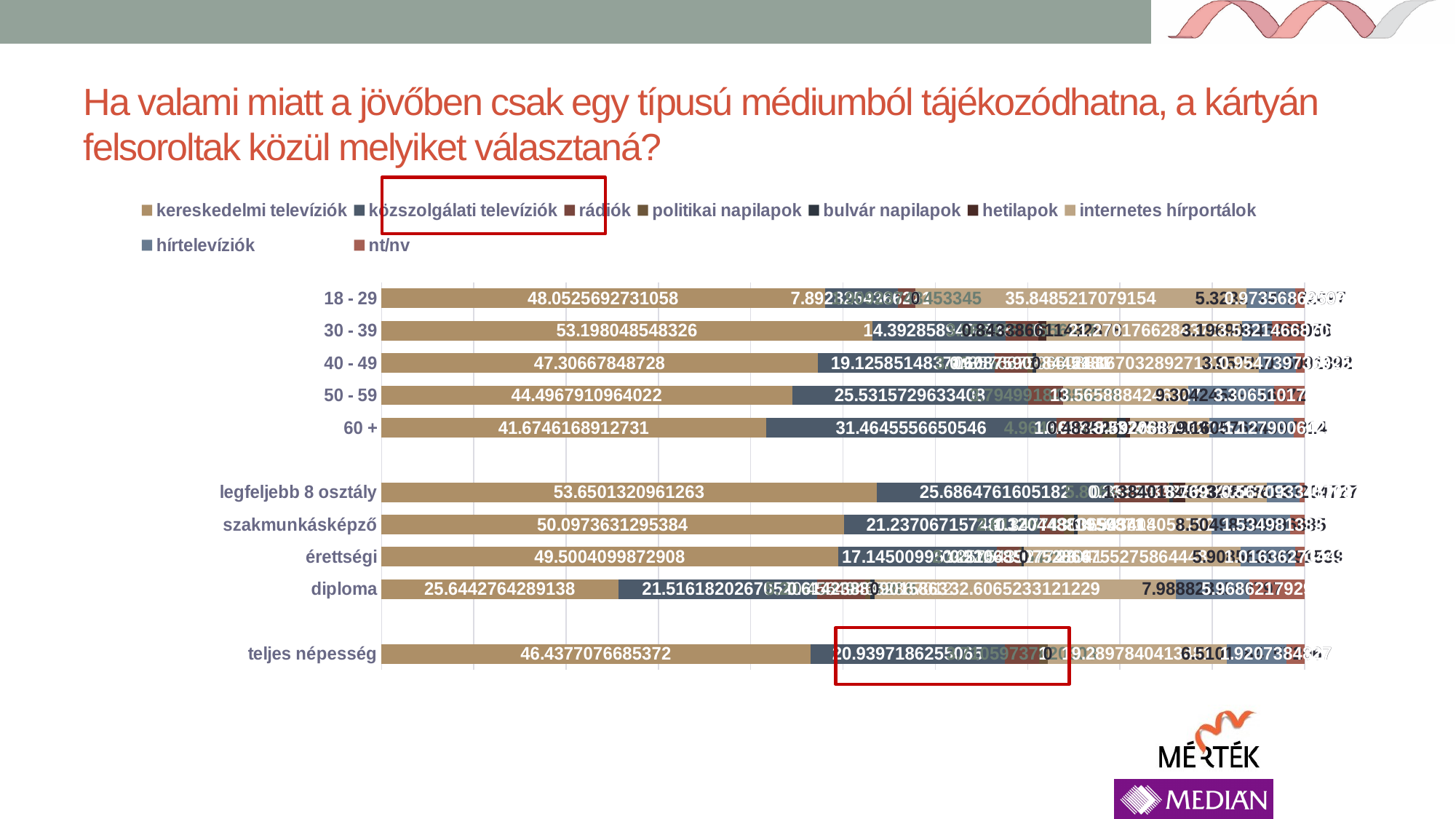
What is the value for kereskedelmi televíziók in the 18 - 29 group? 48.0525692731058 What is the value for közszolgálati televíziók in the 60 + group? 31.4645556650546 What is the value for internetes hírportálok in the 18 - 29 group? 35.8485217079154 Which is larger for közszolgálati televíziók: the 18 - 29 group or the 60 + group? 60 + Which category has the lowest value for kereskedelmi televíziók? diploma How many categories (rows) are plotted in the chart? 10 How many series does the legend list? 9 What is the value for kereskedelmi televíziók for diploma? 25.6442764289138 Which category has the highest value for kereskedelmi televíziók? legfeljebb 8 osztály What kind of chart is shown on the slide? stacked bar chart What is the value for kereskedelmi televíziók for teljes népesség? 46.4377076685372 Across the age groups from 18 - 29 to 60 +, does the value for közszolgálati televíziók rise or fall? rise